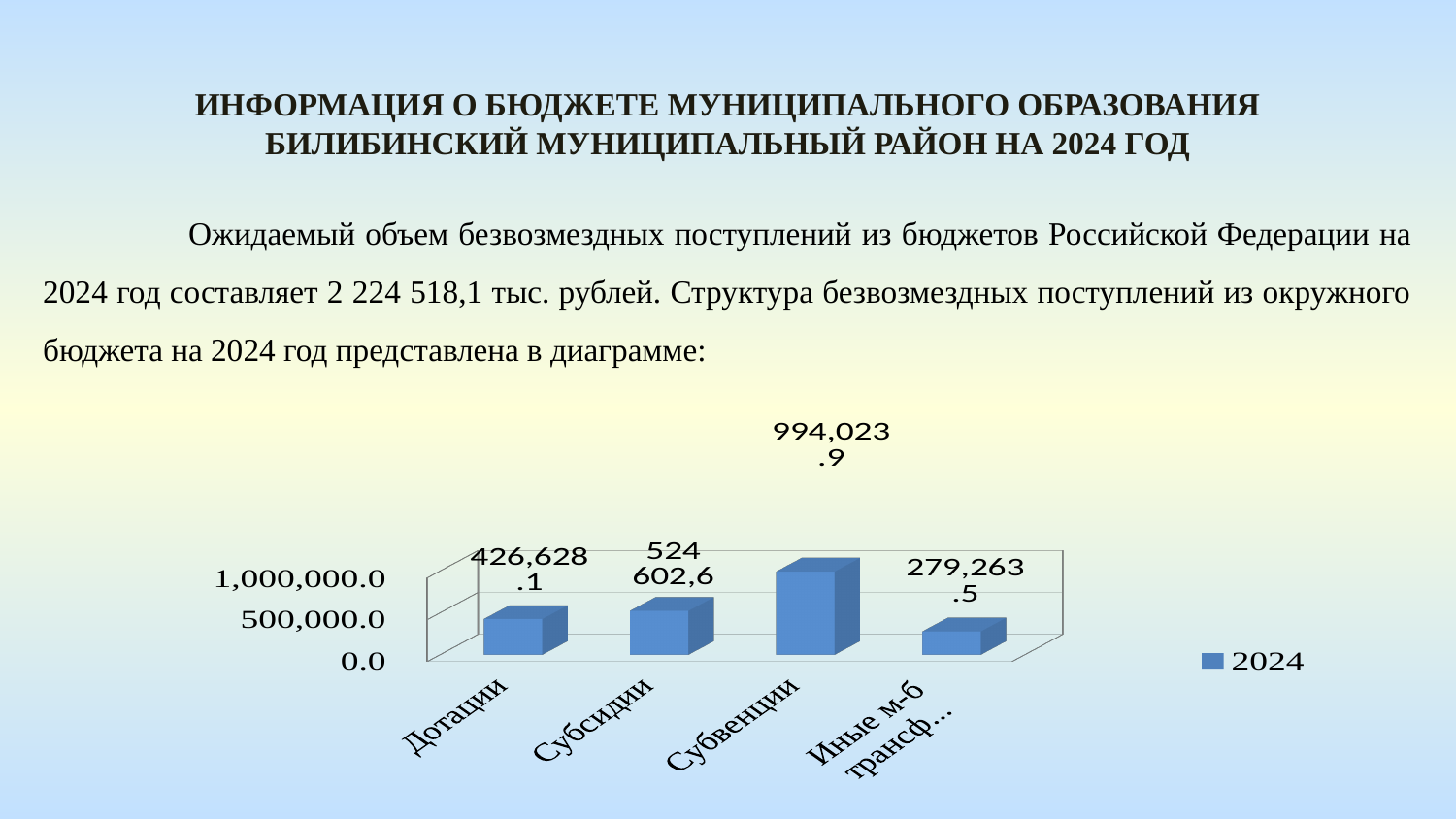
Which category has the lowest value? Иные м-б трансф... How many series does the legend list? 1 Which is larger, the value for Субсидии or the value for Дотации? Субсидии Which category has the highest value? Субвенции What is the value for the category labelled Иные м-б трансф...? 279,263.5 What value is labelled on the Субсидии bar? 524 602,6 Is the value for Субвенции greater or less than 500,000.0? greater What is the value for Дотации? 426,628.1 What is the value for Субвенции? 994,023.9 What is the difference between the values for Субвенции and Дотации? 567,395.8 What kind of chart is shown on the slide? bar chart How many categories are shown on the x axis? 4